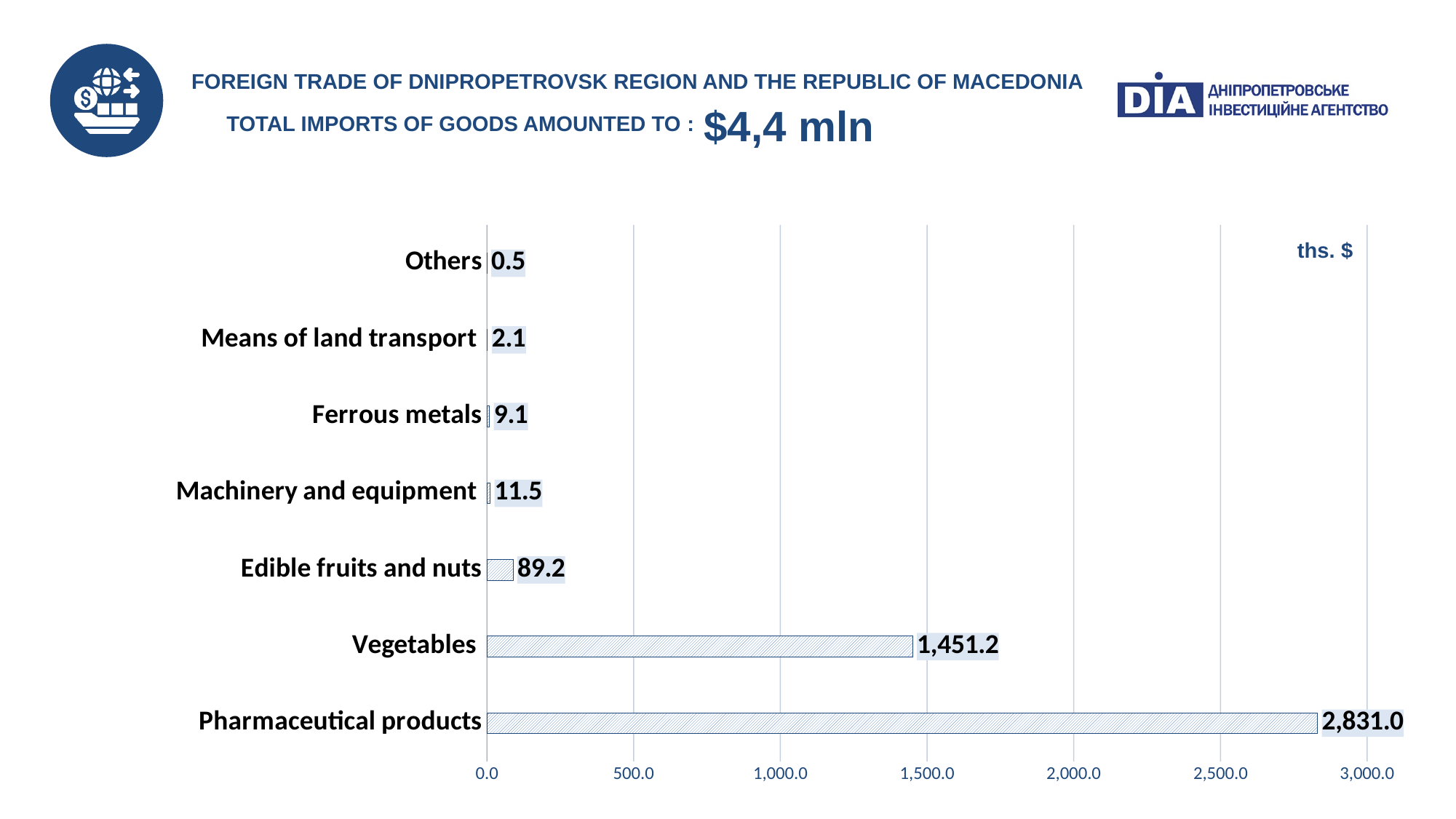
Which is larger, the value for Ferrous metals or the value for Machinery and equipment? Machinery and equipment What is the value for Machinery and equipment? 11.5 Which category has the highest value? Pharmaceutical products What is the difference between the values for Pharmaceutical products and Vegetables? 1,379.8 How many categories are shown in the chart? 7 Is the value for Vegetables greater or less than 1,000.0? greater What is the value for Means of land transport? 2.1 Which category has the lowest value? Others What is the value for Pharmaceutical products? 2,831.0 What is the value for Edible fruits and nuts? 89.2 What is the value for Vegetables? 1,451.2 What kind of chart is shown on the slide? bar chart